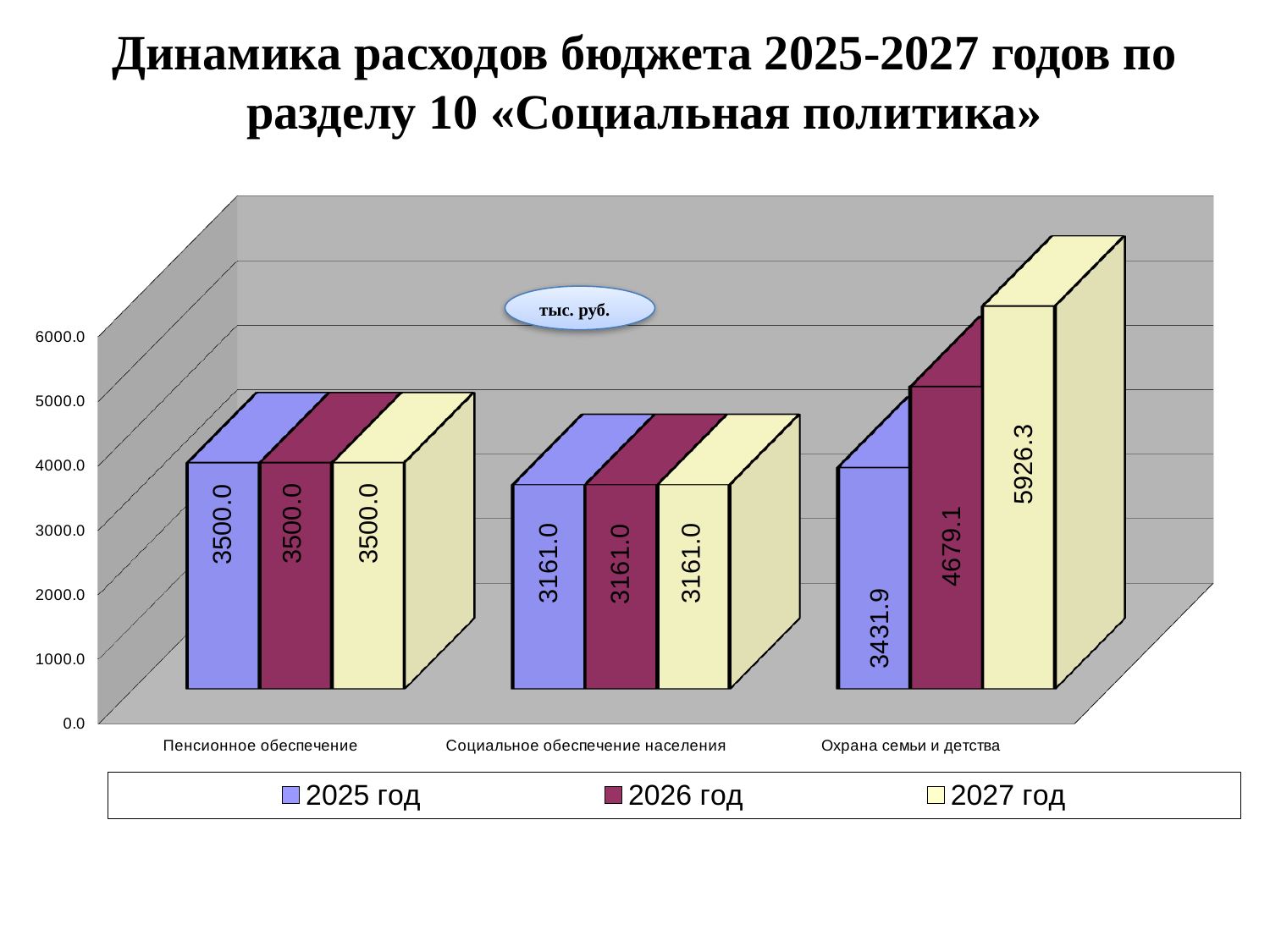
What is the value for Охрана семьи и детства in 2027 год? 5926.3 Which category has the lowest value in 2025 год? Социальное обеспечение населения How many series does the legend list? 3 What kind of chart is shown on the slide? Bar chart What is the value for Социальное обеспечение населения in 2026 год? 3161.0 What is the value for Охрана семьи и детства in 2025 год? 3431.9 What is the difference between the 2027 год and 2025 год values for Охрана семьи и детства? 2494.4 Which category has the highest value in 2027 год? Охрана семьи и детства Do the values for Охрана семьи и детства rise or fall from 2025 год to 2027 год? Rise What is the value for Пенсионное обеспечение in 2025 год? 3500.0 How many categories are shown on the x axis? 3 Which is larger: the 2026 год value for Охрана семьи и детства or the 2026 год value for Пенсионное обеспечение? Охрана семьи и детства